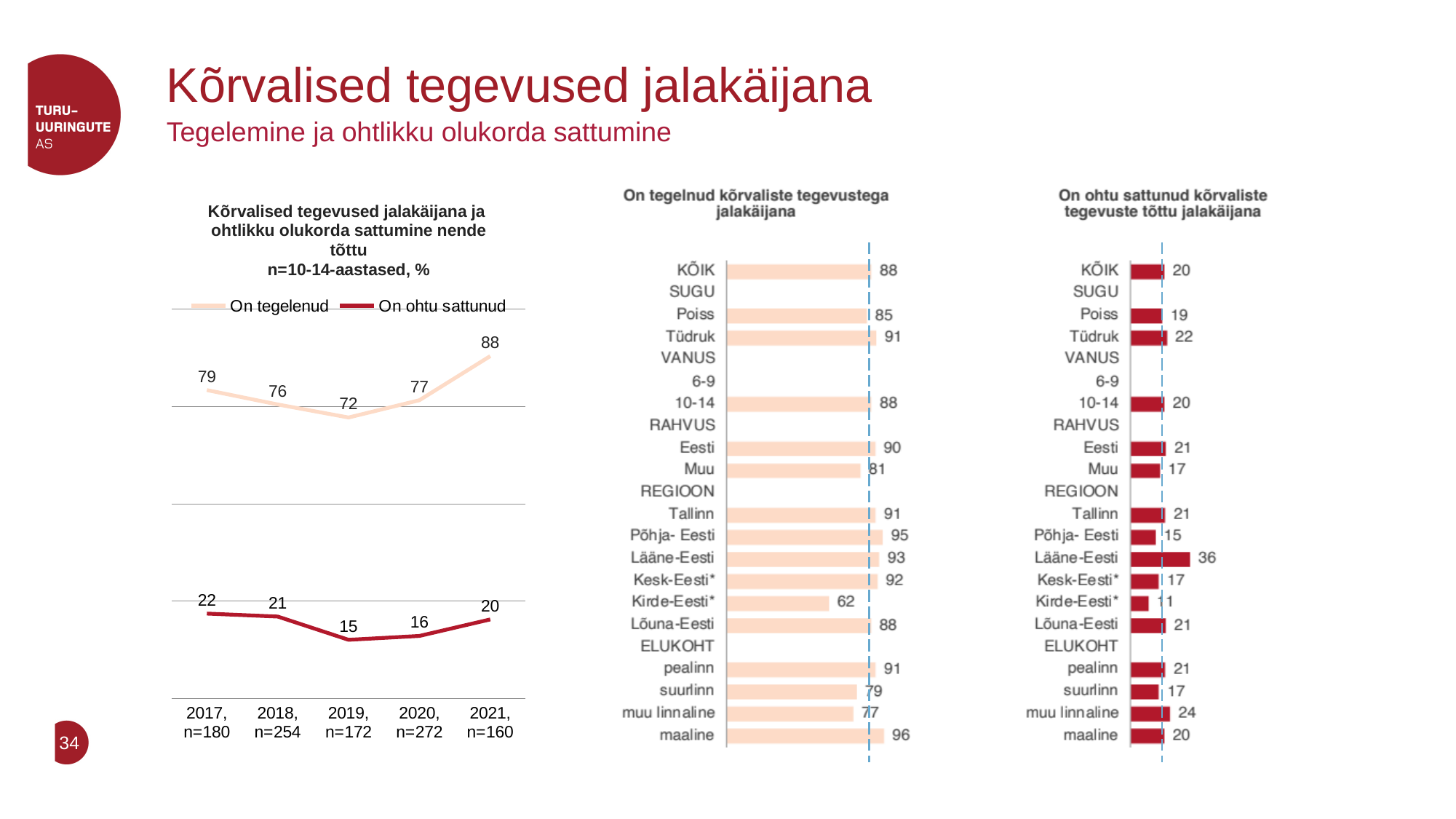
In the line chart on the left, what is the difference between the 'On tegelenud' and 'On ohtu sattunud' values for 2017, n=180? 57 In the line chart on the left, how many series does the legend list? 2 In the chart 'On tegelnud kõrvaliste tegevustega jalakäijana', which category has the highest value? maaline In the line chart on the left, which year has the lowest value for 'On tegelenud'? 2019, n=172 In the chart 'On tegelnud kõrvaliste tegevustega jalakäijana', which is larger, the value for Poiss or the value for Tüdruk? Tüdruk In the line chart on the left, what is the value of 'On ohtu sattunud' for 2019, n=172? 15 What kind of chart is 'On ohtu sattunud kõrvaliste tegevuste tõttu jalakäijana'? Bar chart In the chart 'On tegelnud kõrvaliste tegevustega jalakäijana', what is the value for Kirde-Eesti*? 62 In the line chart on the left, what is the value of 'On tegelenud' for 2021, n=160? 88 In the chart 'On ohtu sattunud kõrvaliste tegevuste tõttu jalakäijana', what is the difference between the values for Lääne-Eesti and Kirde-Eesti*? 25 In the line chart on the left, how many years are shown on the x axis? 5 In the chart 'On ohtu sattunud kõrvaliste tegevuste tõttu jalakäijana', which category has the highest value? Lääne-Eesti